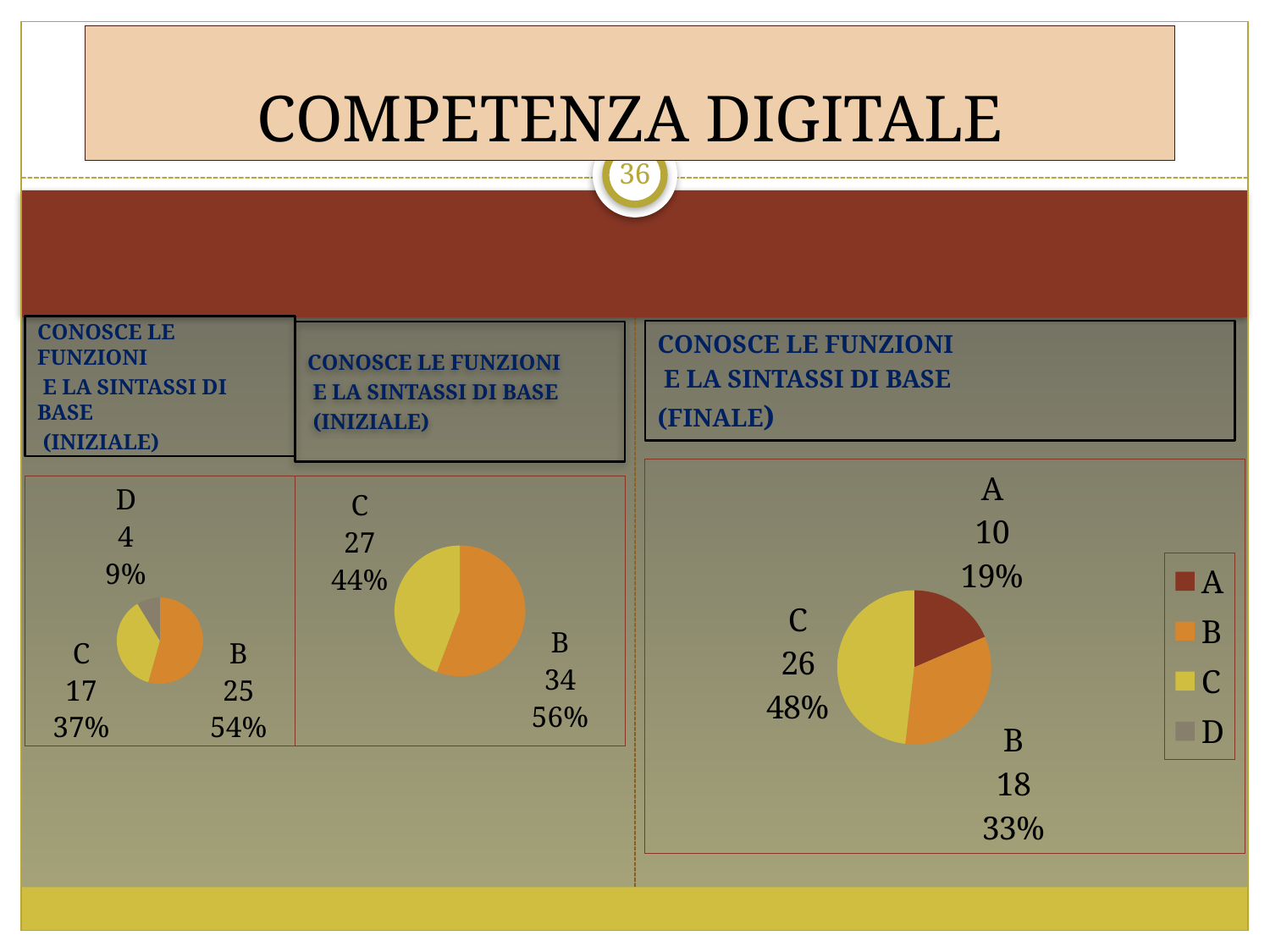
In the left-hand pie chart (INIZIALE), which category has the smallest value? D In the right-hand pie chart (FINALE), how many entries does the legend list? 4 In the middle pie chart (INIZIALE), how many categories are shown? 2 In the right-hand pie chart (FINALE), what percentage share does category B have? 33% In the right-hand pie chart (FINALE), what is the value for category A? 10 In the middle pie chart (INIZIALE), what percentage share does category B have? 56% What type of chart is the right-hand chart (FINALE)? Pie chart In the left-hand pie chart (INIZIALE), what is the difference between the values for B and C? 8 In the right-hand pie chart (FINALE), which category has the largest value? C In the left-hand pie chart (INIZIALE), what is the value for category B? 25 In the middle pie chart (INIZIALE), what is the value for category C? 27 In the left-hand pie chart (INIZIALE), what percentage share does category D have? 9%